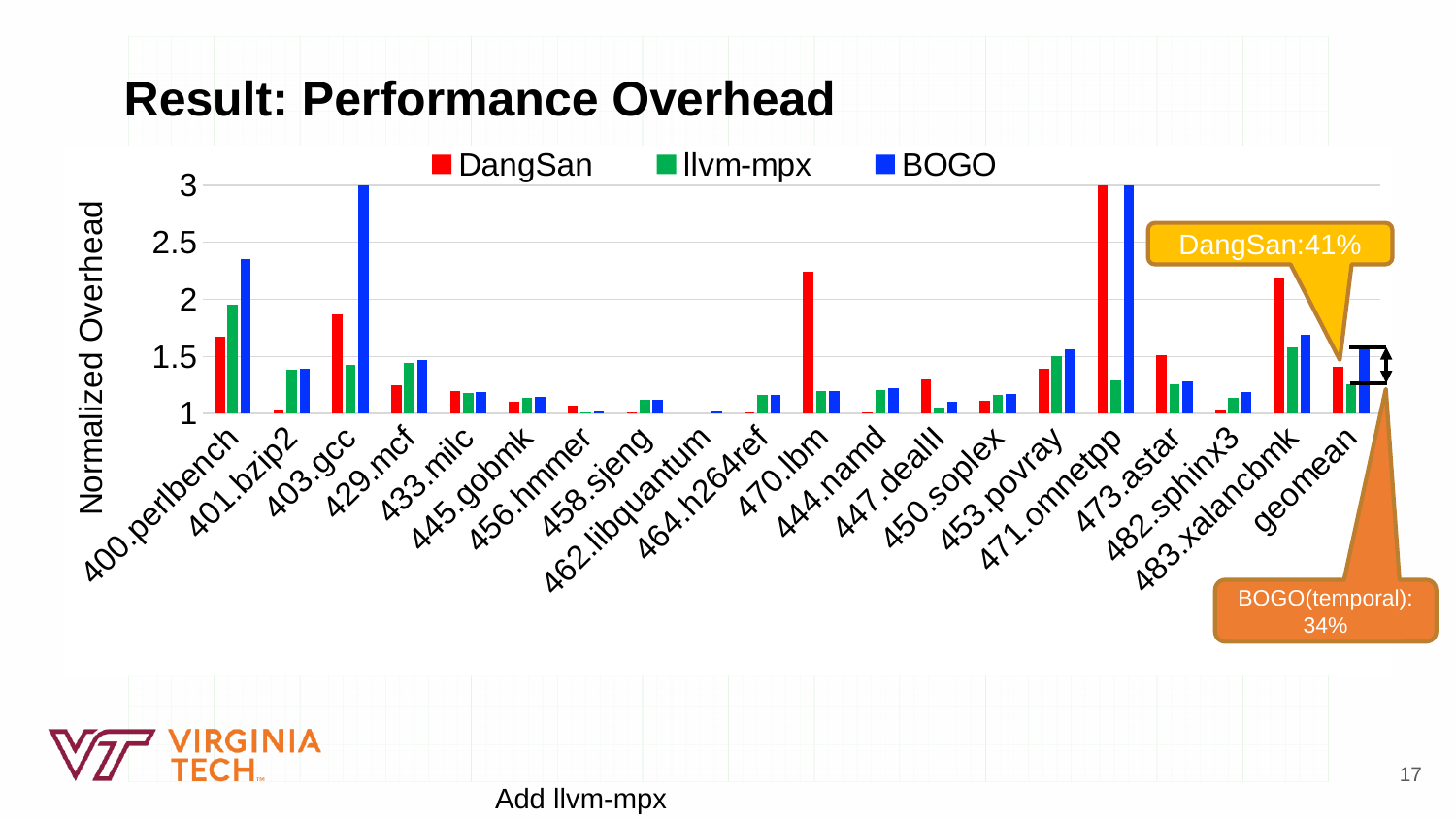
Which category has the highest DangSan value? 471.omnetpp Is the DangSan value for 429.mcf greater or less than 1.5? less Is the DangSan value for 483.xalancbmk greater or less than 2? greater What is the label of the y axis? Normalized Overhead Is the DangSan value for 470.lbm greater or less than 2? greater How many series does the legend list? 3 Which series is drawn in blue? BOGO How many categories are shown along the x axis? 20 For 470.lbm, which is larger: the DangSan value or the BOGO value? DangSan For 403.gcc, which is larger: the BOGO value or the llvm-mpx value? BOGO What kind of chart is shown on the slide? bar chart